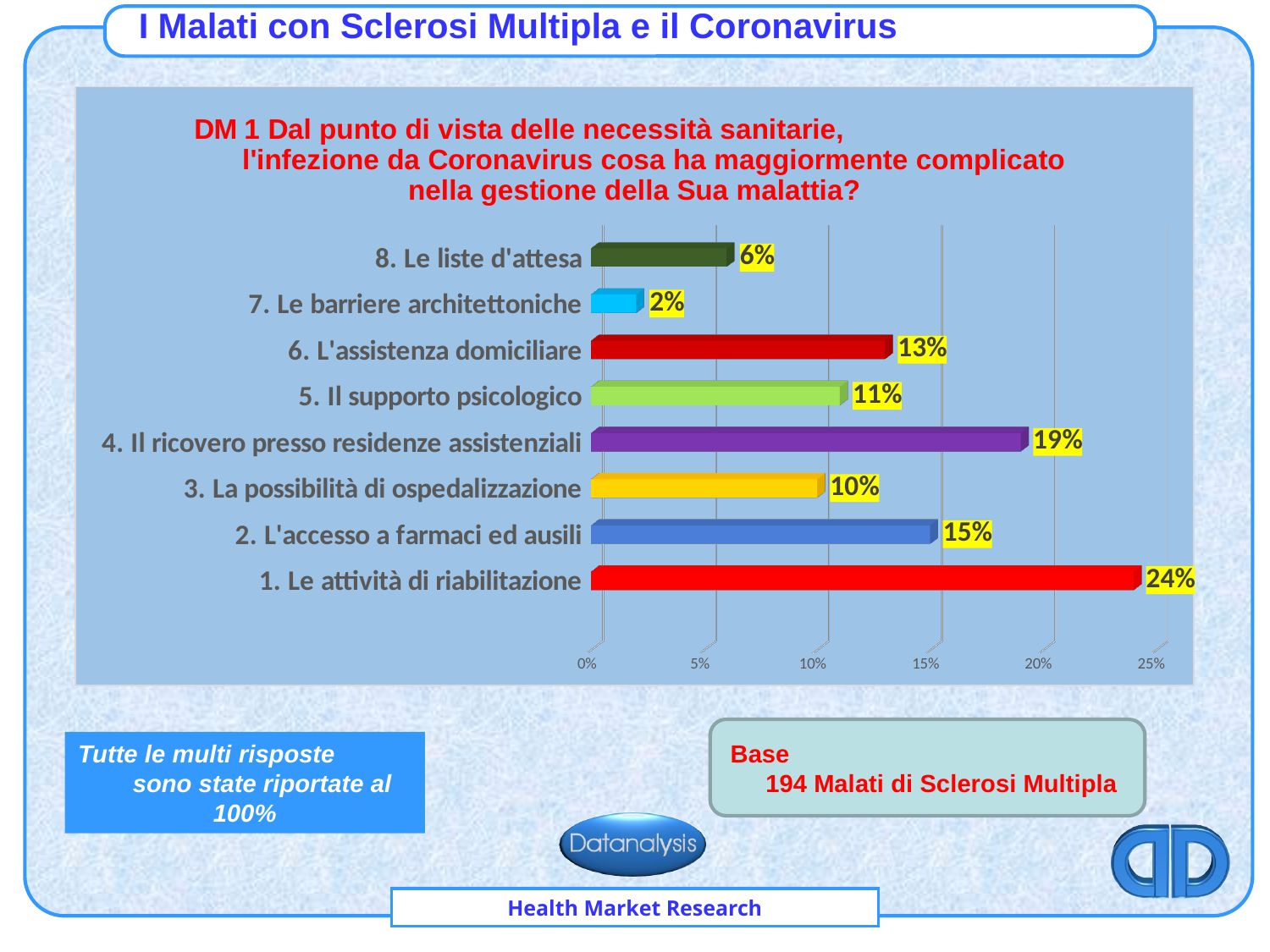
Which category has the lowest value? 7. Le barriere architettoniche What is the value for "7. Le barriere architettoniche"? 2% What is the value for "1. Le attività di riabilitazione"? 24% Which is larger, the value for "6. L'assistenza domiciliare" or the value for "8. Le liste d'attesa"? 6. L'assistenza domiciliare How many categories are shown in the chart? 8 What is the value for "5. Il supporto psicologico"? 11% What is the difference between the values for "2. L'accesso a farmaci ed ausili" and "3. La possibilità di ospedalizzazione"? 5% What is the base (number of respondents) stated on the slide? 194 Malati di Sclerosi Multipla Which category has the highest value? 1. Le attività di riabilitazione What is the value for "4. Il ricovero presso residenze assistenziali"? 19% What kind of chart is shown on the slide? bar chart Is the value for "2. L'accesso a farmaci ed ausili" greater or less than 10%? greater